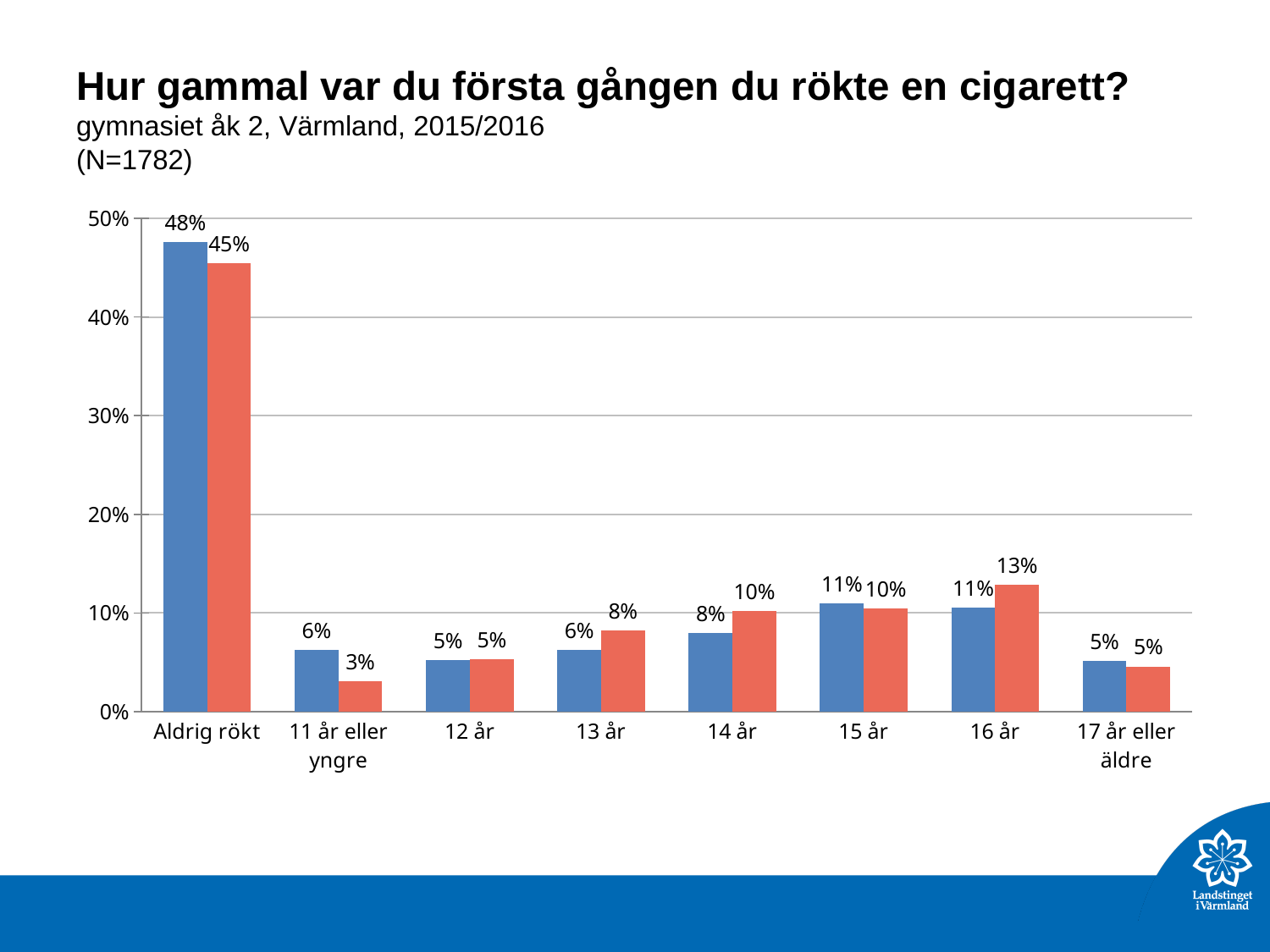
How many categories are shown on the x axis? 8 Which category has the highest blue bar? Aldrig rökt For "14 år", which bar is larger, the blue or the red? red What is the value of the red bar for "16 år"? 13% What is the value of the red bar for "Aldrig rökt"? 45% What kind of chart is shown on the slide? bar chart Is the blue bar for "Aldrig rökt" greater or less than 40%? greater What is the value of the red bar for "11 år eller yngre"? 3% What is the difference between the blue bars for "Aldrig rökt" and "16 år"? 37% What is the difference between the blue and red bars for "11 år eller yngre"? 3% What is the value of the blue bar for "Aldrig rökt"? 48% Which category has the lowest red bar? 11 år eller yngre